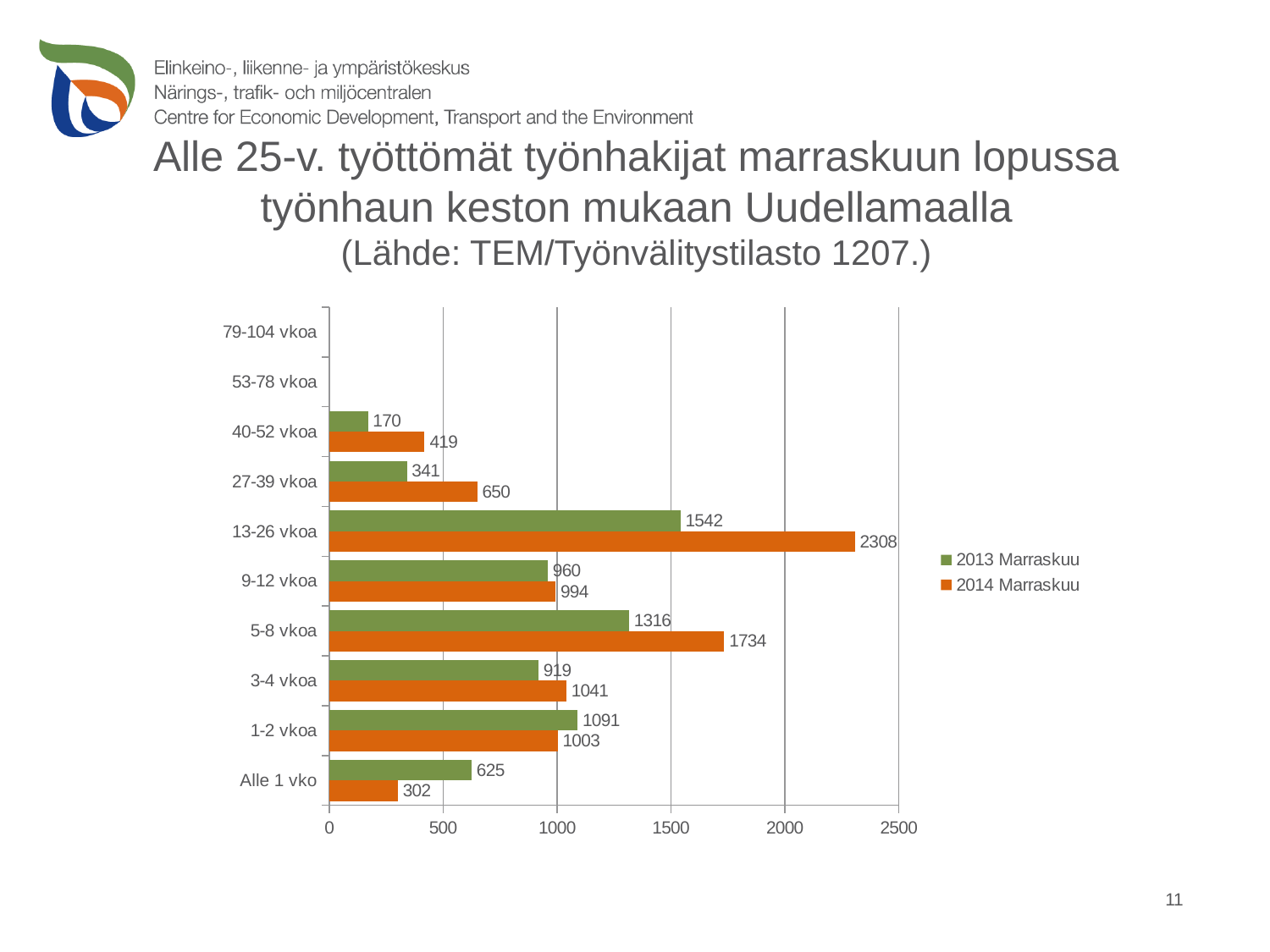
What is the difference between the 2014 Marraskuu and 2013 Marraskuu values for 13-26 vkoa? 766 How many series does the legend list? 2 For 1-2 vkoa, which is larger: the 2013 Marraskuu value or the 2014 Marraskuu value? 2013 Marraskuu Is the 2014 Marraskuu value for 5-8 vkoa greater or less than 1500? greater Which colour represents the 2014 Marraskuu series? Orange Among the categories with a labelled bar, which has the lowest 2013 Marraskuu value? 40-52 vkoa Which category has the highest 2014 Marraskuu value? 13-26 vkoa What kind of chart is shown on the slide? Bar chart How many categories are listed on the vertical axis? 10 What is the 2014 Marraskuu value for 13-26 vkoa? 2308 What is the 2013 Marraskuu value for 5-8 vkoa? 1316 What is the 2014 Marraskuu value for Alle 1 vko? 302